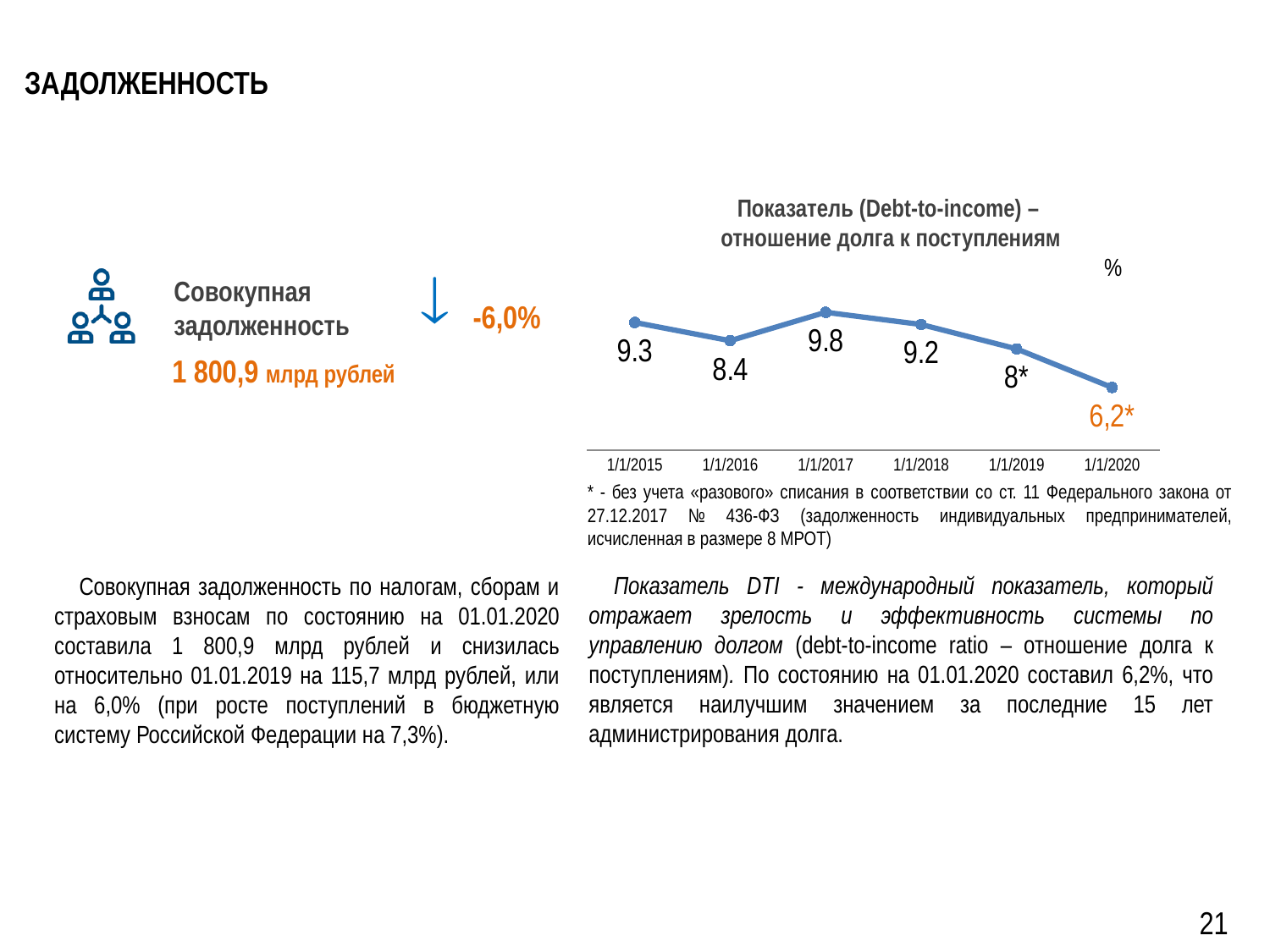
What is the difference between the values for 1/1/2017 and 1/1/2016? 1.4 Which is larger, the value for 1/1/2015 or the value for 1/1/2018? 1/1/2015 Does the debt-to-income indicator rise or fall from 1/1/2017 to 1/1/2020? fall How many data points are plotted on the chart? 6 On which date does the debt-to-income indicator reach its highest value? 1/1/2017 On which date does the debt-to-income indicator reach its lowest value? 1/1/2020 What value is labelled for 1/1/2020 on the chart? 6,2* What type of chart is shown on the slide? line chart What is the title of the chart? Показатель (Debt-to-income) – отношение долга к поступлениям What is the value of the debt-to-income indicator on 1/1/2018? 9.2 What is the value of the debt-to-income indicator on 1/1/2015? 9.3 What is the value of the debt-to-income indicator on 1/1/2016? 8.4